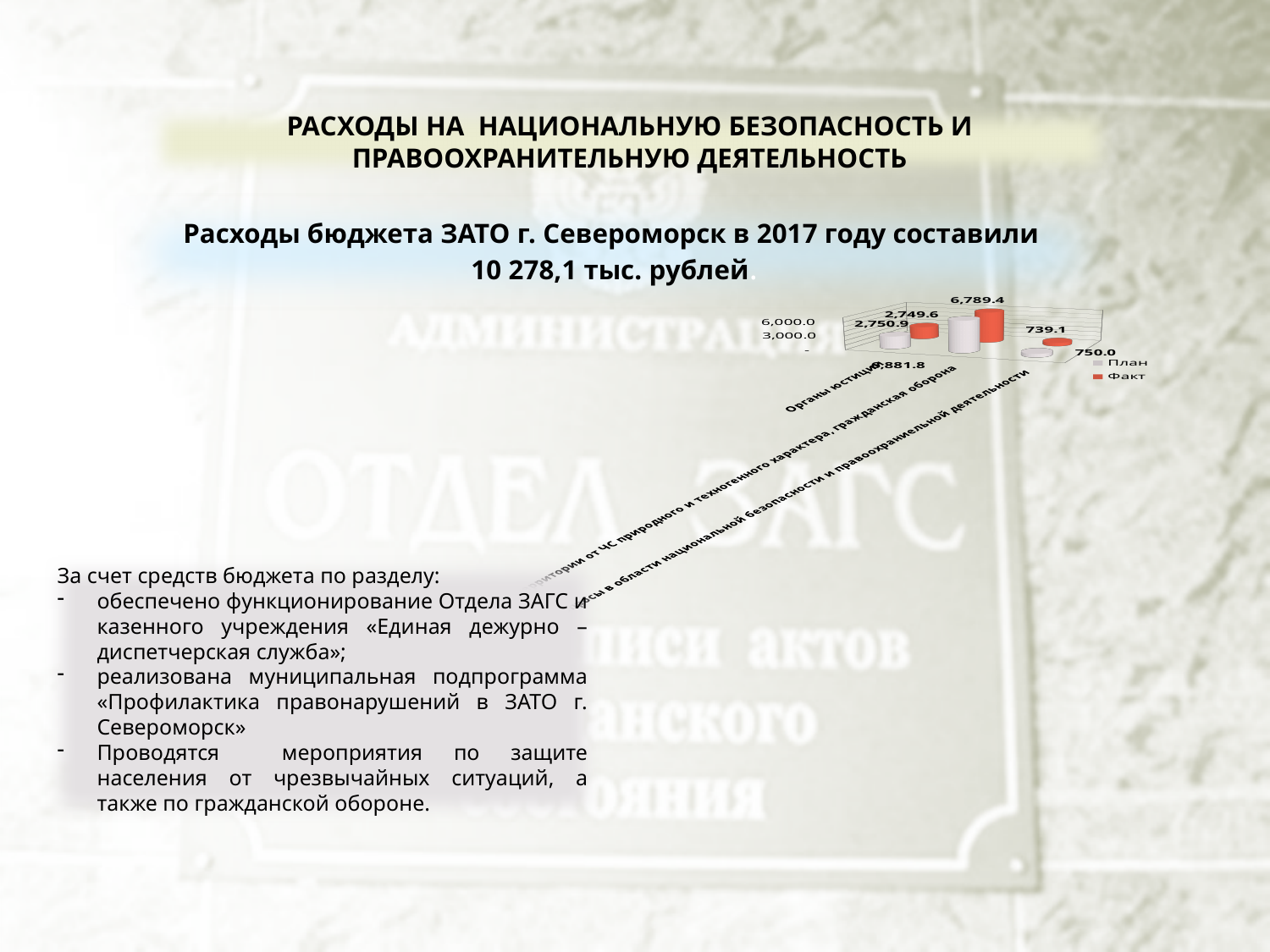
Is the Факт value for the category ending in «гражданская оборона» greater or less than 6,000.0? greater What is the difference between the План and Факт values for Органы юстиции? 1.3 What kind of chart is shown on the slide? bar chart Which category has the highest Факт value? Защита населения и территории от ЧС природного и техногенного характера, гражданская оборона What is the difference between the План value of 750.0 and the Факт value of 739.1 for the category ending in «правоохранительной деятельности»? 10.9 What is the Факт value for the category ending in «правоохранительной деятельности»? 739.1 How many series does the chart legend list? 2 What is the Факт value for Органы юстиции? 2,749.6 What are the two series named in the chart legend? План and Факт What is the Факт value for the category ending in «гражданская оборона»? 6,789.4 How many categories are plotted in the chart? 3 What is the План value for Органы юстиции? 2,750.9